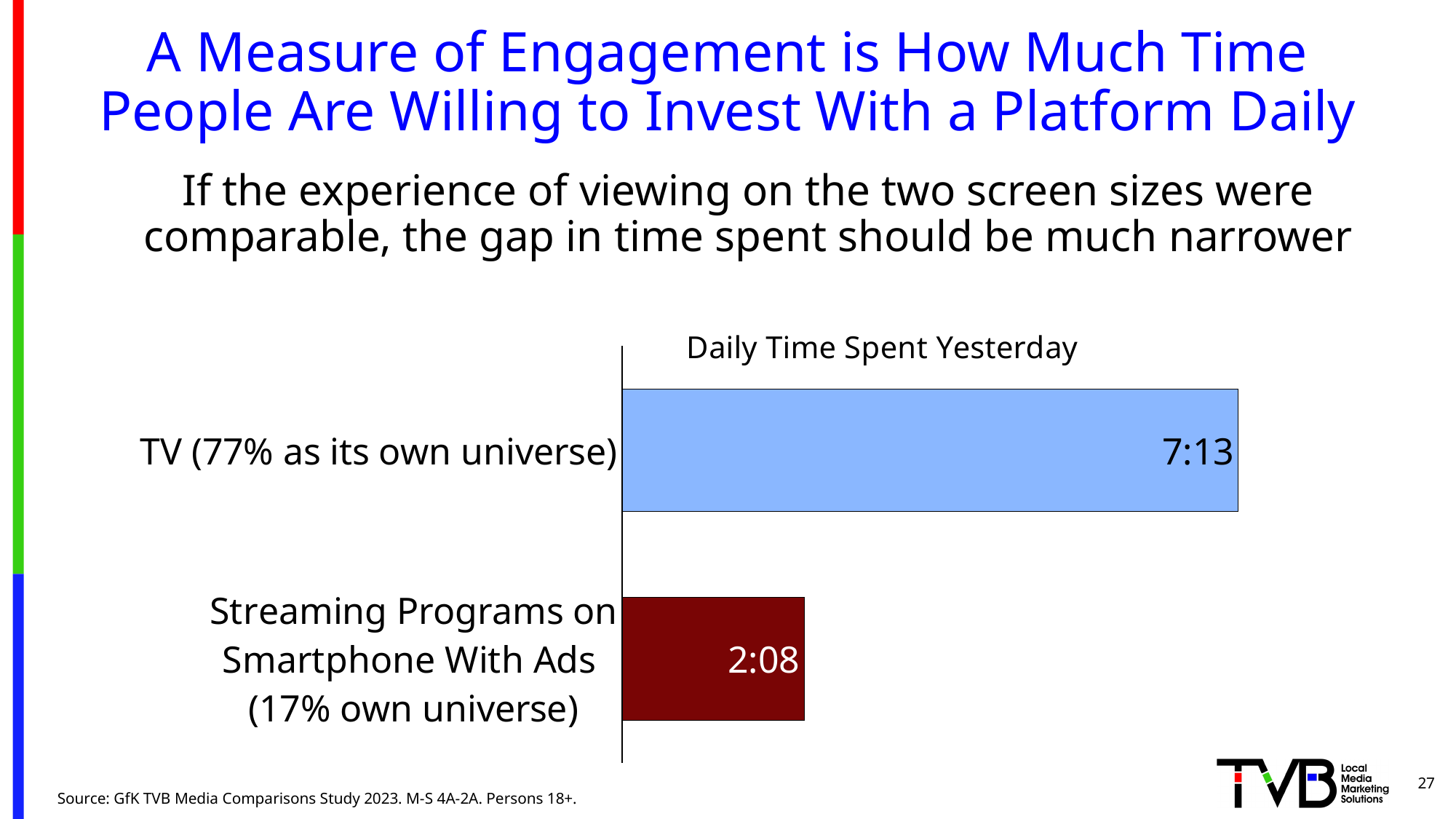
What is the title of the chart? Daily Time Spent Yesterday Which category has the lowest daily time spent yesterday? Streaming Programs on Smartphone With Ads (17% own universe) How many categories are shown in the chart? 2 What colour is the bar for Streaming Programs on Smartphone With Ads? Dark red Which has a larger daily time spent: TV or Streaming Programs on Smartphone With Ads? TV Which category has the highest daily time spent yesterday? TV (77% as its own universe) What is the daily time spent yesterday for Streaming Programs on Smartphone With Ads (17% own universe)? 2:08 What is the daily time spent yesterday for TV (77% as its own universe)? 7:13 What kind of chart is shown on the slide? Bar chart What is the difference in daily time spent between TV (7:13) and Streaming Programs on Smartphone With Ads (2:08)? 5:05